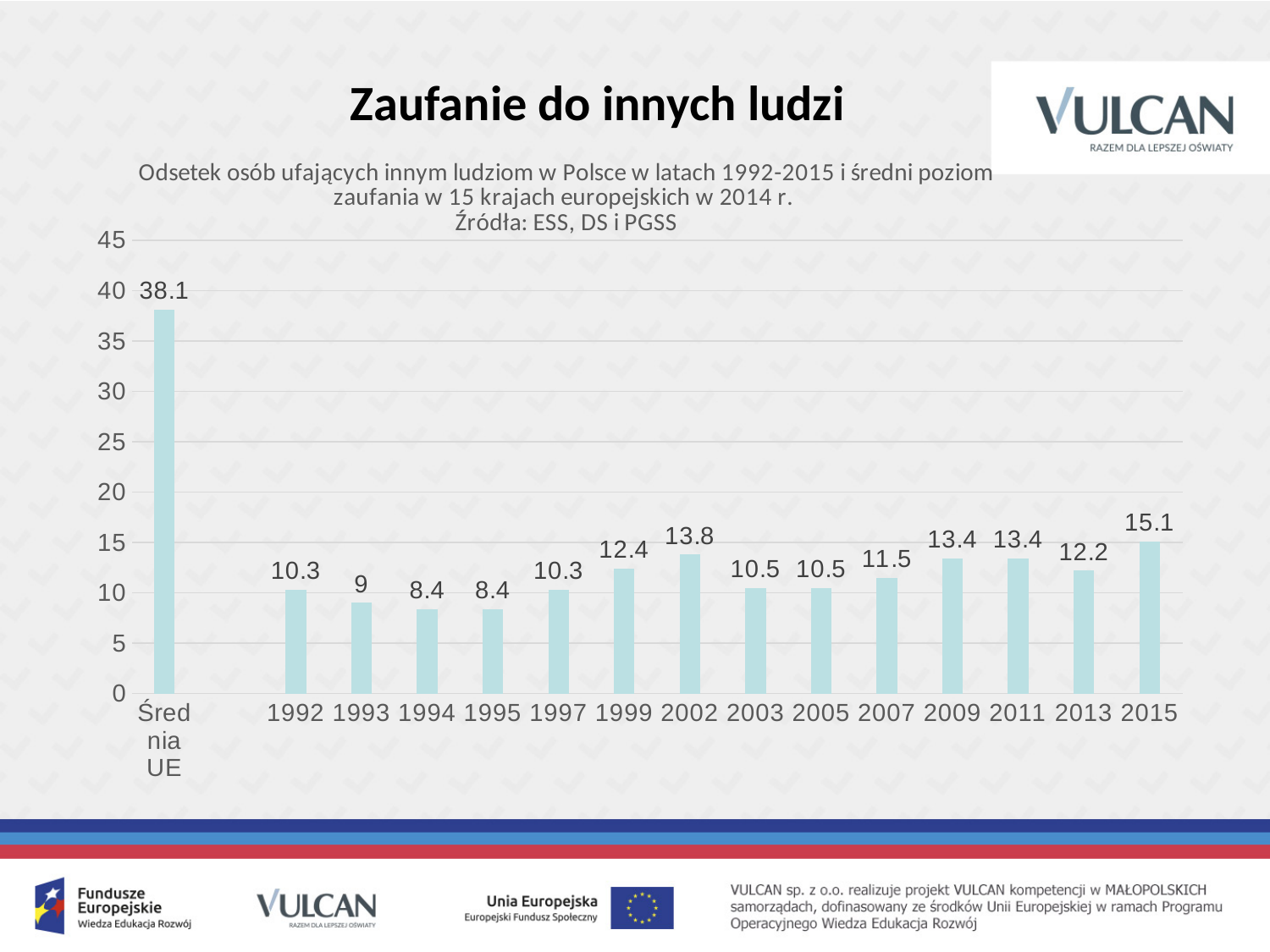
What is the lowest value shown in the chart? 8.4 Which is larger, the value for 2002 or the value for 2007? 2002 What is the title of the chart? Odsetek osób ufających innym ludziom w Polsce w latach 1992-2015 i średni poziom zaufania w 15 krajach europejskich w 2014 r. Źródła: ESS, DS i PGSS Which category has the highest value? Średnia UE What is the value for 2002? 13.8 What is the value for 1993? 9 How many bars are shown in the chart? 15 What is the value for Średnia UE? 38.1 What is the difference between the value for 2015 and the value for 1992? 4.8 What type of chart is shown on the slide? bar chart What is the difference between the value for Średnia UE and the value for 2015? 23 What is the value for 2015? 15.1